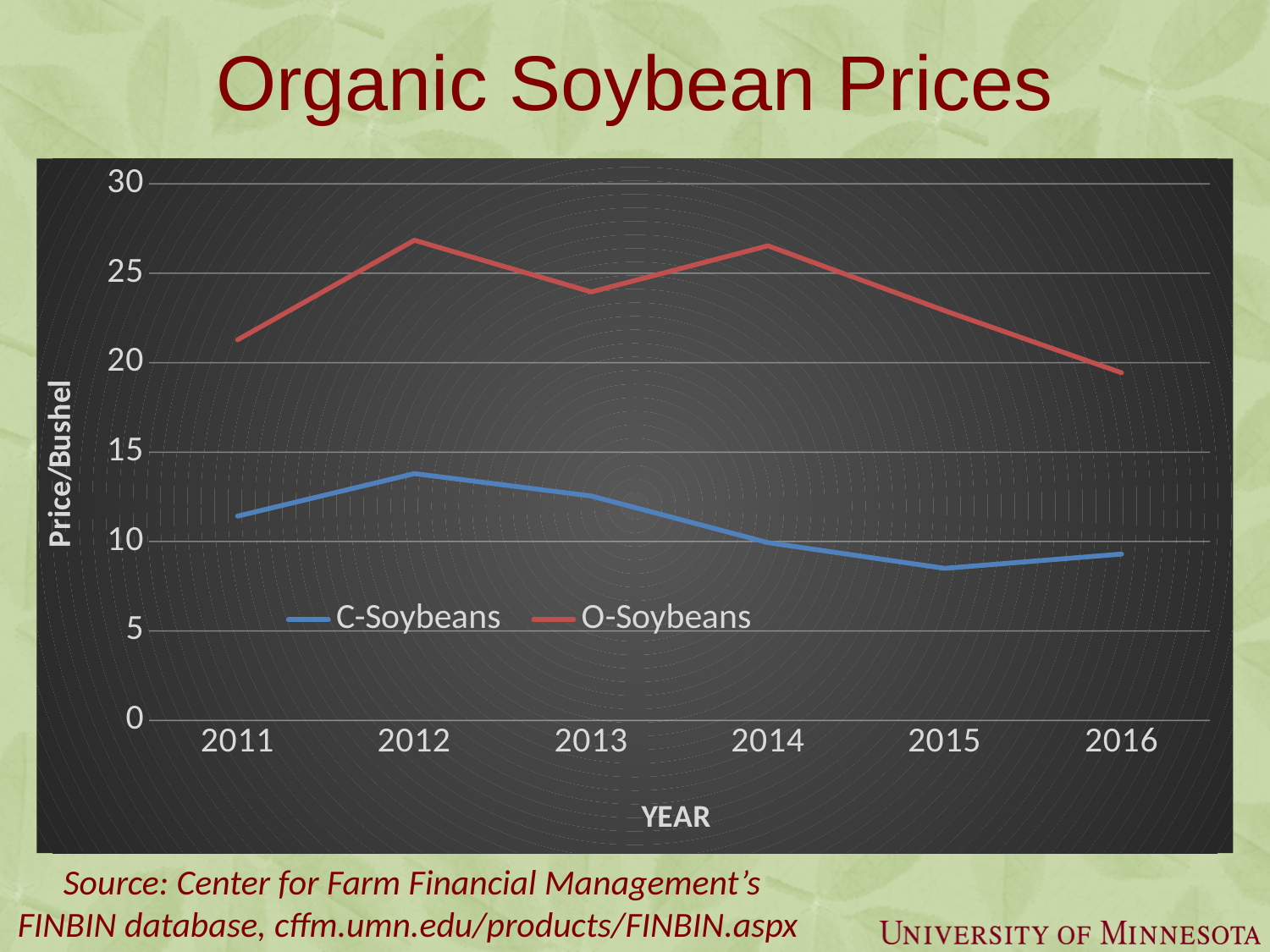
Is the O-Soybeans price in 2016 greater or less than 20? less In which year is the O-Soybeans price lowest? 2016 Does the O-Soybeans price rise or fall from 2014 to 2016? fall What is the label on the y axis? Price/Bushel How many series does the legend list? 2 Which series is higher in 2014, C-Soybeans or O-Soybeans? O-Soybeans Is the C-Soybeans price in 2015 greater or less than 10? less What kind of chart is shown on the slide? line chart How many years are shown on the x axis? 6 Is the O-Soybeans price in 2012 greater or less than 25? greater In which year is the C-Soybeans price highest? 2012 In which year is the C-Soybeans price lowest? 2015